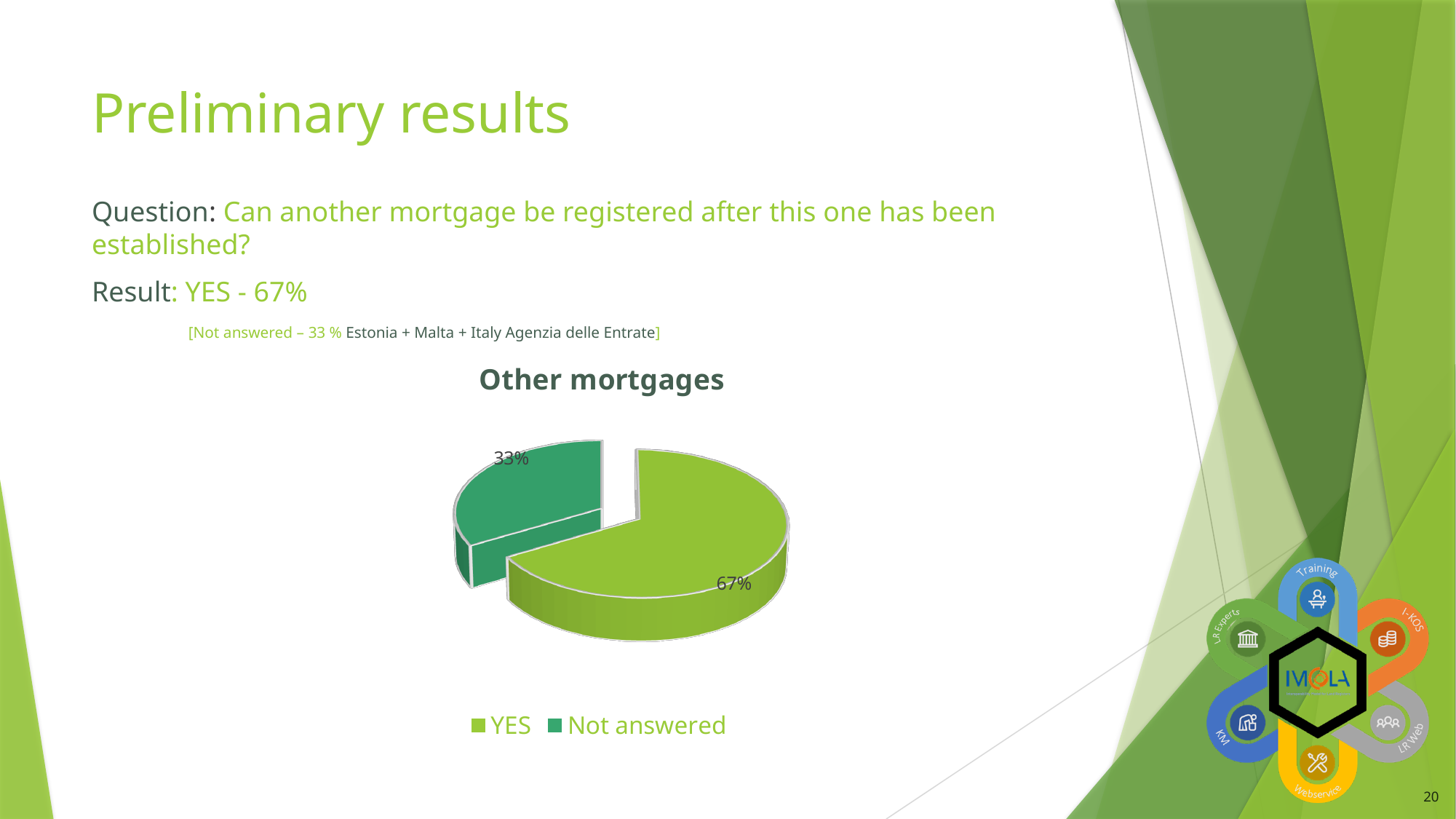
What share of the pie does YES represent? 67% How many entries does the legend list? 2 Which legend entry is shown in the lighter green colour? YES Which slice of the pie is the smallest? Not answered What is the title of the chart? Other mortgages What share of the pie does Not answered represent? 33% Which is larger, the YES slice or the Not answered slice? YES How many slices does the pie chart have? 2 Which slice of the pie is the largest? YES What kind of chart is shown on the slide? pie chart What is the difference in percentage points between the YES slice and the Not answered slice? 34